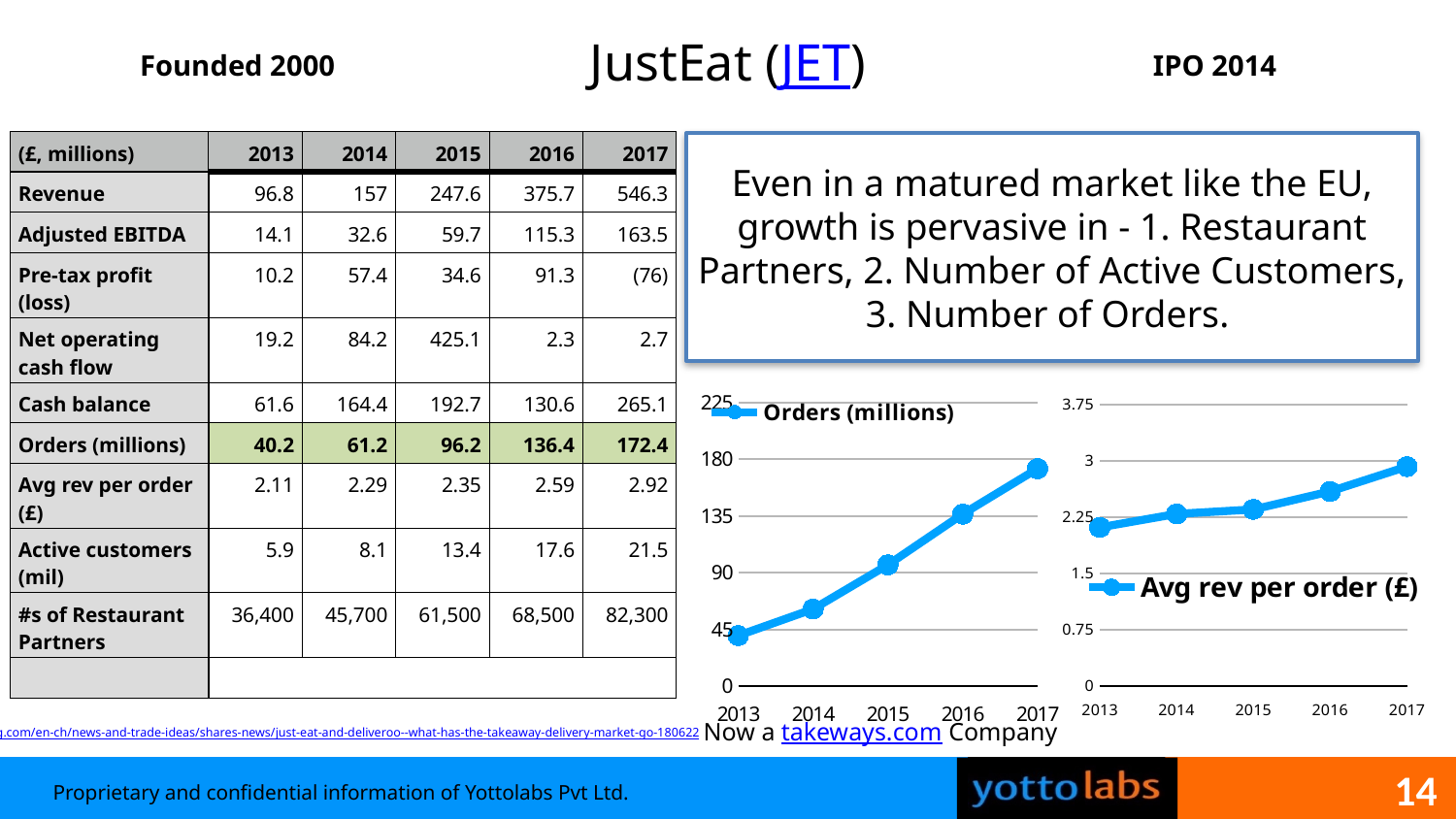
In the "Orders (millions)" chart, is the value for 2017 greater or less than 180? less What type of chart is the "Orders (millions)" chart? line chart In the "Orders (millions)" chart, is the value for 2013 greater or less than 45? less In the "Orders (millions)" chart, is the value for 2015 greater or less than 90? greater How many years are plotted on the x axis of the "Orders (millions)" chart? 5 In the "Orders (millions)" chart, which year has the lowest value? 2013 In the "Avg rev per order (£)" chart, which is larger, the value for 2017 or the value for 2014? 2017 In the "Orders (millions)" chart, do the values rise or fall from 2013 to 2017? rise How many series does the legend of the "Avg rev per order (£)" chart list? 1 In the "Orders (millions)" chart, which year has the highest value? 2017